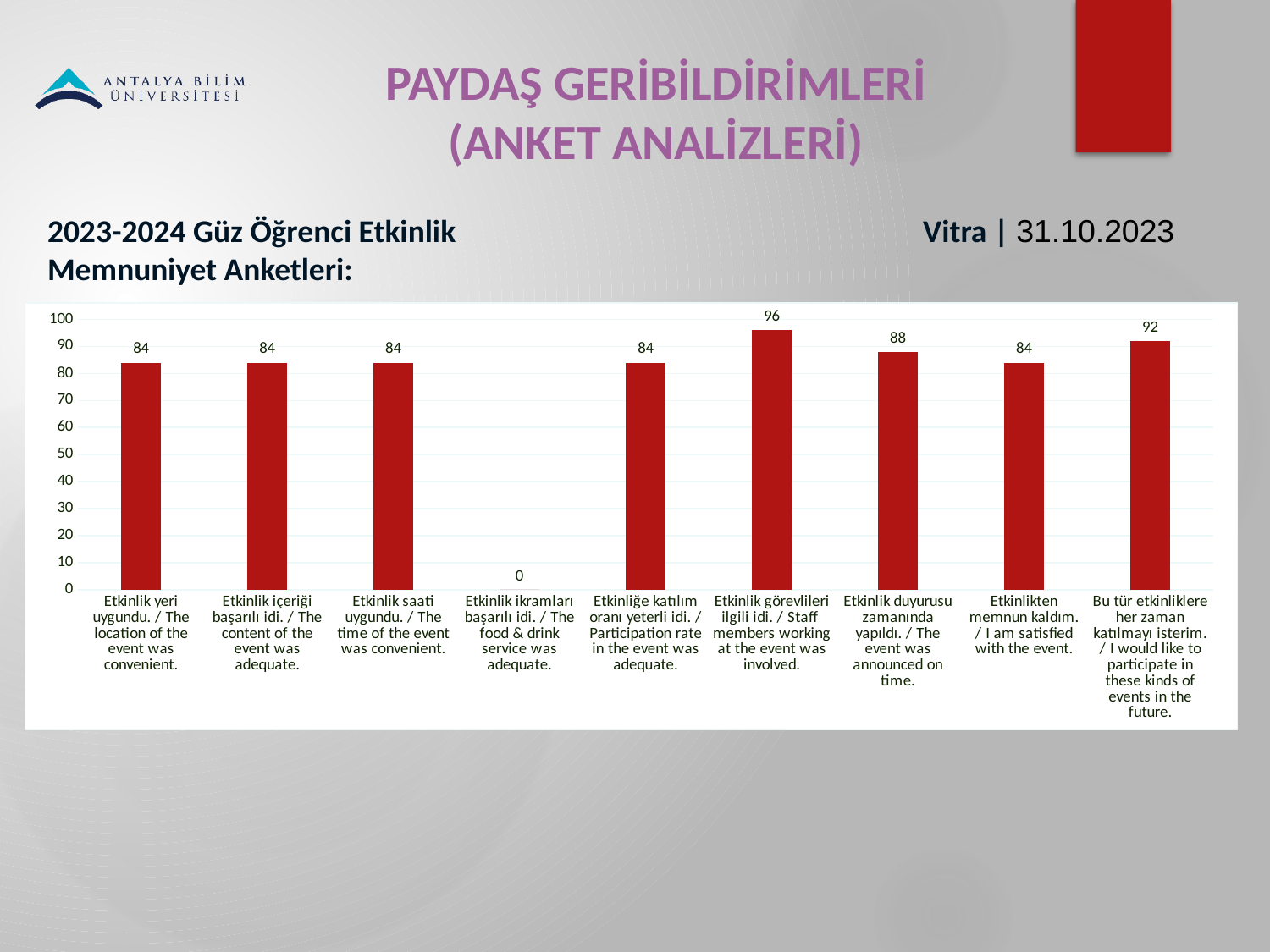
Which category has the lowest value? Etkinlik ikramları başarılı idi. / The food & drink service was adequate. What is the maximum value shown on the vertical axis of the chart? 100 Which category has the highest value? Etkinlik görevlileri ilgili idi. / Staff members working at the event was involved. What kind of chart is shown on the slide? bar chart Is the value for "Etkinlik yeri uygundu. / The location of the event was convenient." greater or less than 50? greater Which is larger: the value for "Bu tür etkinliklere her zaman katılmayı isterim." or the value for "Etkinlikten memnun kaldım."? Bu tür etkinliklere her zaman katılmayı isterim. What is the value for "Etkinlik duyurusu zamanında yapıldı. / The event was announced on time."? 88 What is the value for "Etkinlik ikramları başarılı idi. / The food & drink service was adequate."? 0 What is the value for "Etkinlik görevlileri ilgili idi. / Staff members working at the event was involved."? 96 What is the value for "Bu tür etkinliklere her zaman katılmayı isterim. / I would like to participate in these kinds of events in the future."? 92 What is the difference between the value for "Etkinlik görevlileri ilgili idi." and the value for "Etkinlik duyurusu zamanında yapıldı."? 8 How many categories are plotted in the chart? 9